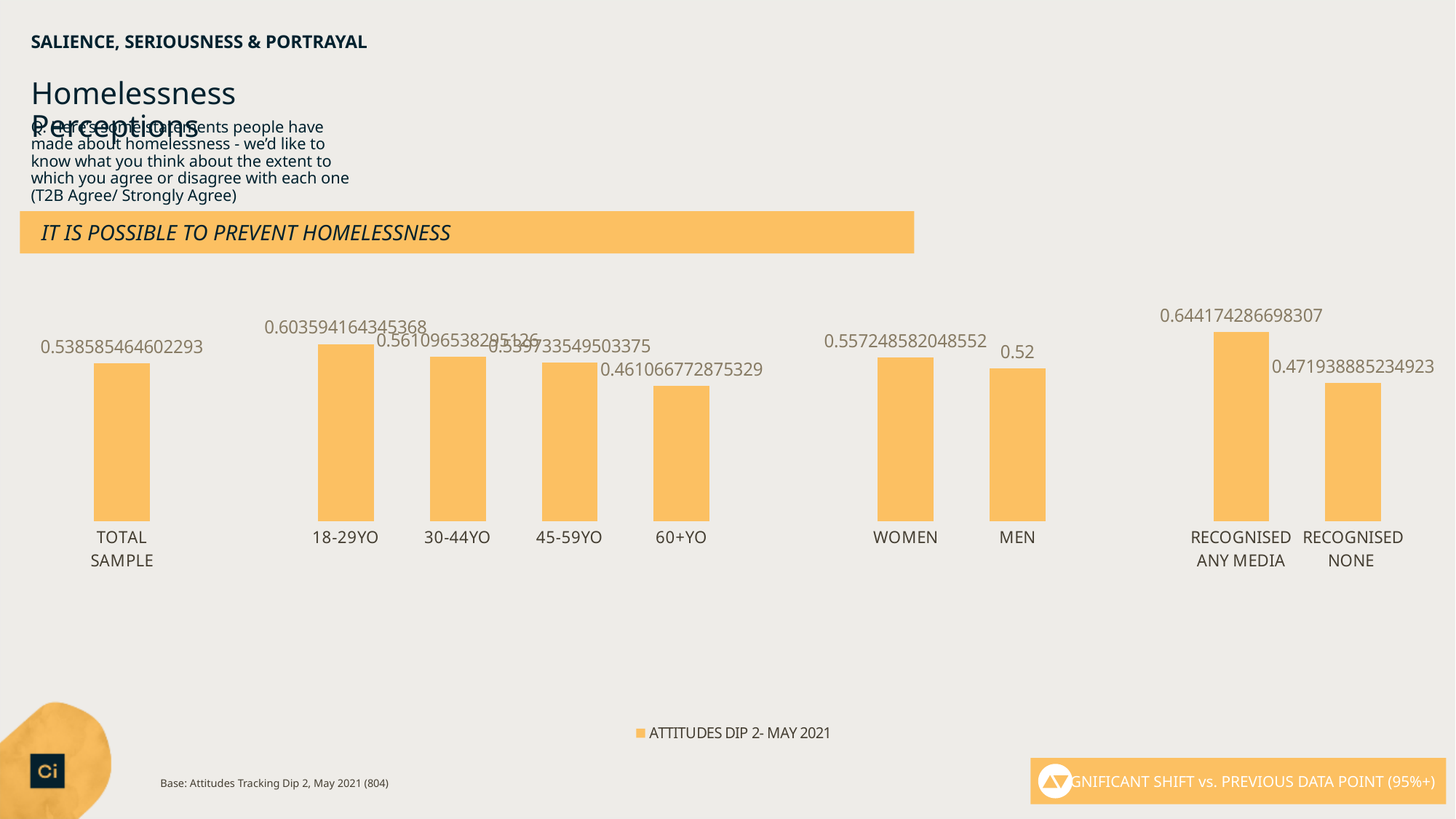
What series does the legend list? ATTITUDES DIP 2- MAY 2021 What is the value for 18-29YO? 0.603594164345368 Which category has the highest value? RECOGNISED ANY MEDIA Which is larger, the value for WOMEN or the value for MEN? WOMEN What is the value for MEN? 0.52 What is the value for RECOGNISED ANY MEDIA? 0.644174286698307 What is the value for 60+YO? 0.461066772875329 What is the difference between the values for 18-29YO and 60+YO? 0.142527391470039 Do the values rise or fall across the age groups from 18-29YO to 60+YO? fall Which category has the lowest value? 60+YO What is the value for TOTAL SAMPLE? 0.538585464602293 How many categories are shown on the chart? 9